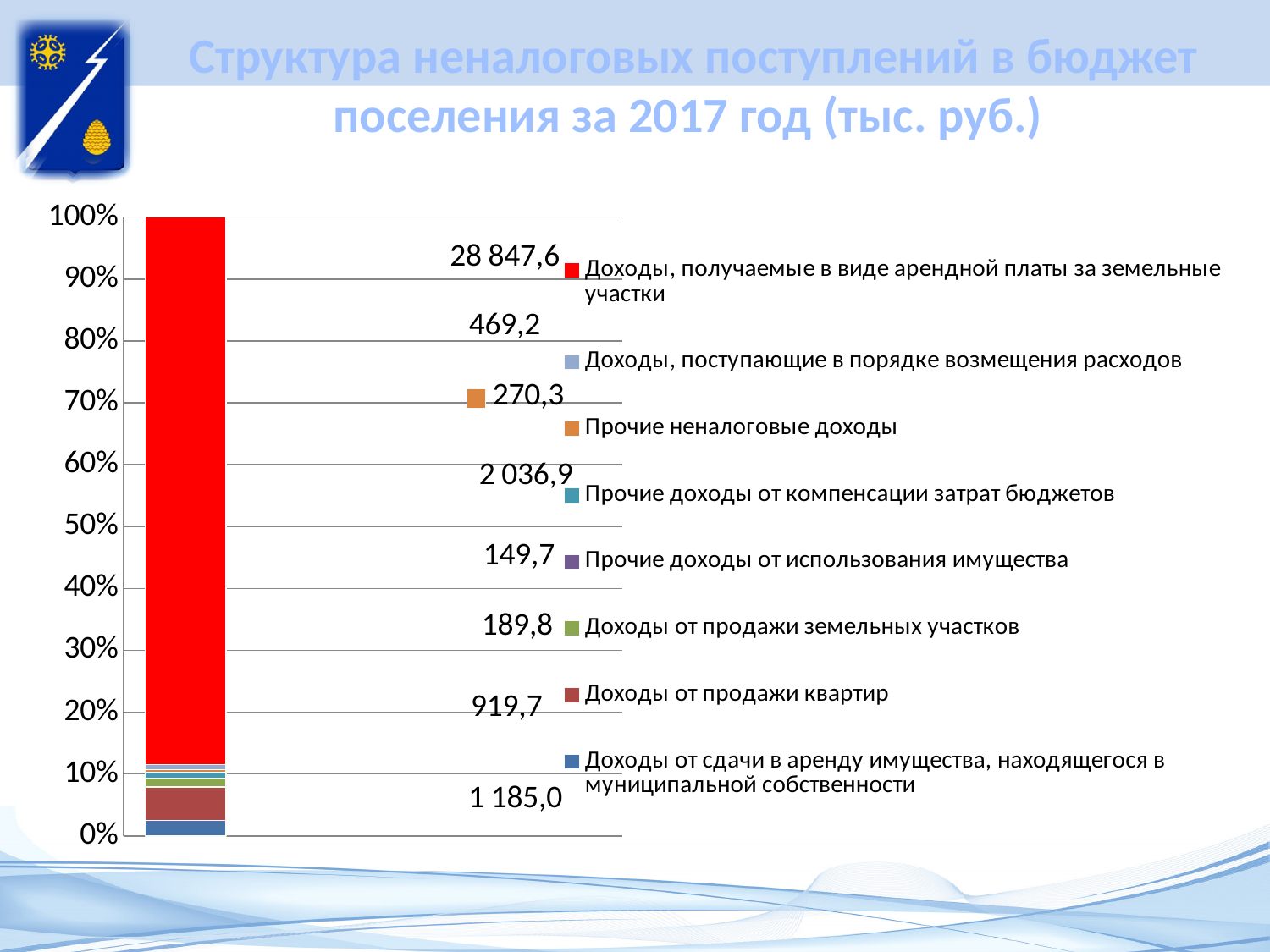
What is the value for «Доходы от продажи квартир»? 919,7 What is the value for «Прочие доходы от компенсации затрат бюджетов»? 2 036,9 What is the value for «Доходы от сдачи в аренду имущества, находящегося в муниципальной собственности»? 1 185,0 What kind of chart is shown on the slide? Stacked bar chart Which is larger: «Доходы, поступающие в порядке возмещения расходов» or «Доходы от продажи земельных участков»? Доходы, поступающие в порядке возмещения расходов Which series has the highest value? Доходы, получаемые в виде арендной платы за земельные участки What is the difference between «Доходы от сдачи в аренду имущества, находящегося в муниципальной собственности» and «Доходы от продажи квартир»? 265,3 What is the value for «Прочие неналоговые доходы»? 270,3 Which series has the lowest value? Прочие доходы от использования имущества What is the value for «Доходы, получаемые в виде арендной платы за земельные участки»? 28 847,6 What is the title of the chart on the slide? Структура неналоговых поступлений в бюджет поселения за 2017 год (тыс. руб.) How many series does the legend list? 8